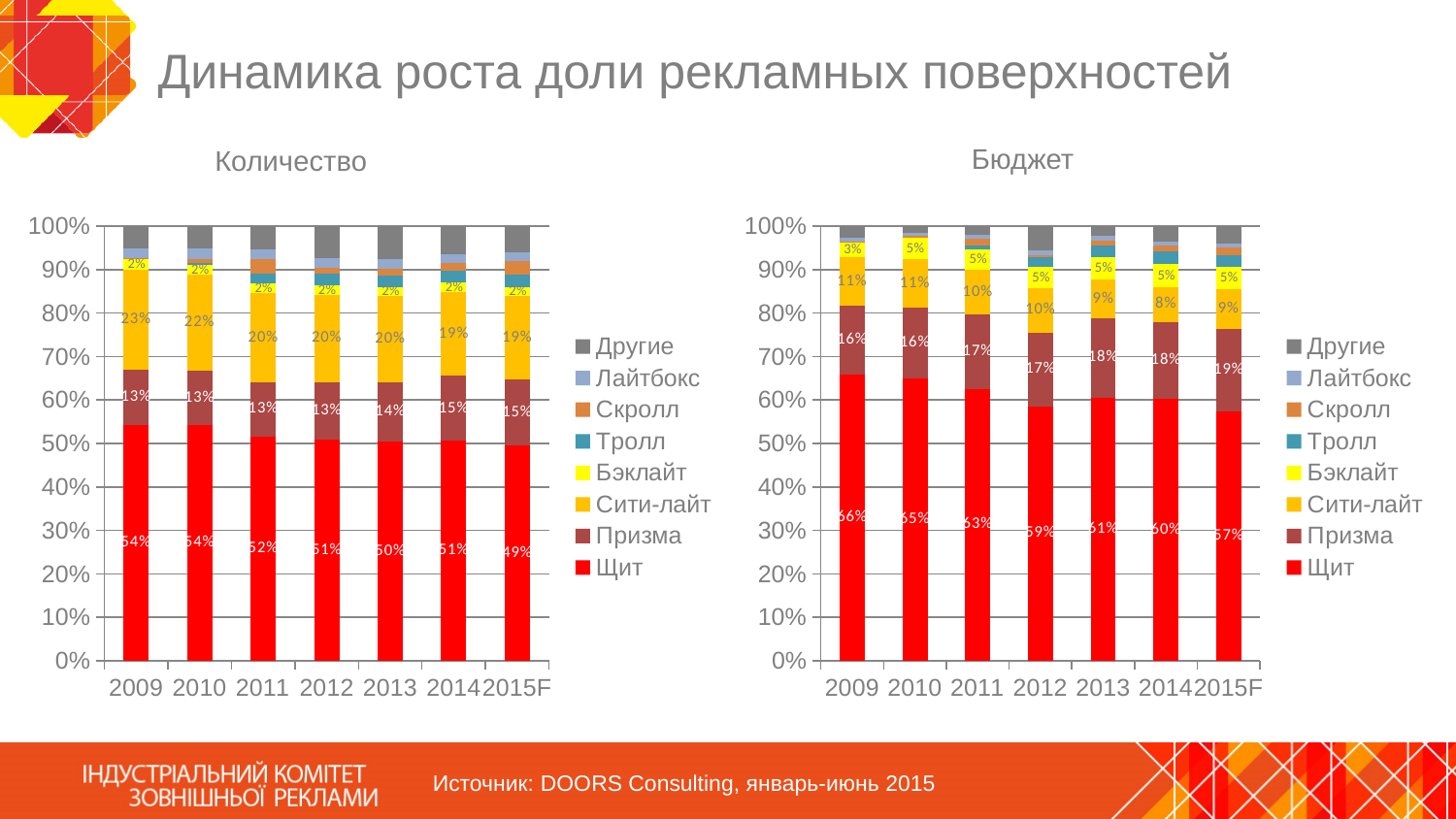
How many years are shown on the x axis of the "Бюджет" chart? 7 In the "Количество" chart, in which year is the Щит share lowest? 2015F How many series does the legend of the "Количество" chart list? 8 In the "Бюджет" chart, what is the value for Щит in 2015F? 57% In the "Количество" chart, what is the value for Щит in 2009? 54% What kind of chart is the "Бюджет" chart? Stacked bar chart In the "Бюджет" chart, in which year is the Щит share highest? 2009 In the "Количество" chart, which is larger in 2014: Призма or Сити-лайт? Сити-лайт In the "Бюджет" chart, what is the value for Призма in 2013? 18% In the "Количество" chart, what is the value for Сити-лайт in 2015F? 19% In the "Бюджет" chart, what is the difference between the Щит value in 2009 and in 2015F? 9% In the "Бюджет" chart, does the Призма share rise or fall from 2009 to 2015F? Rise